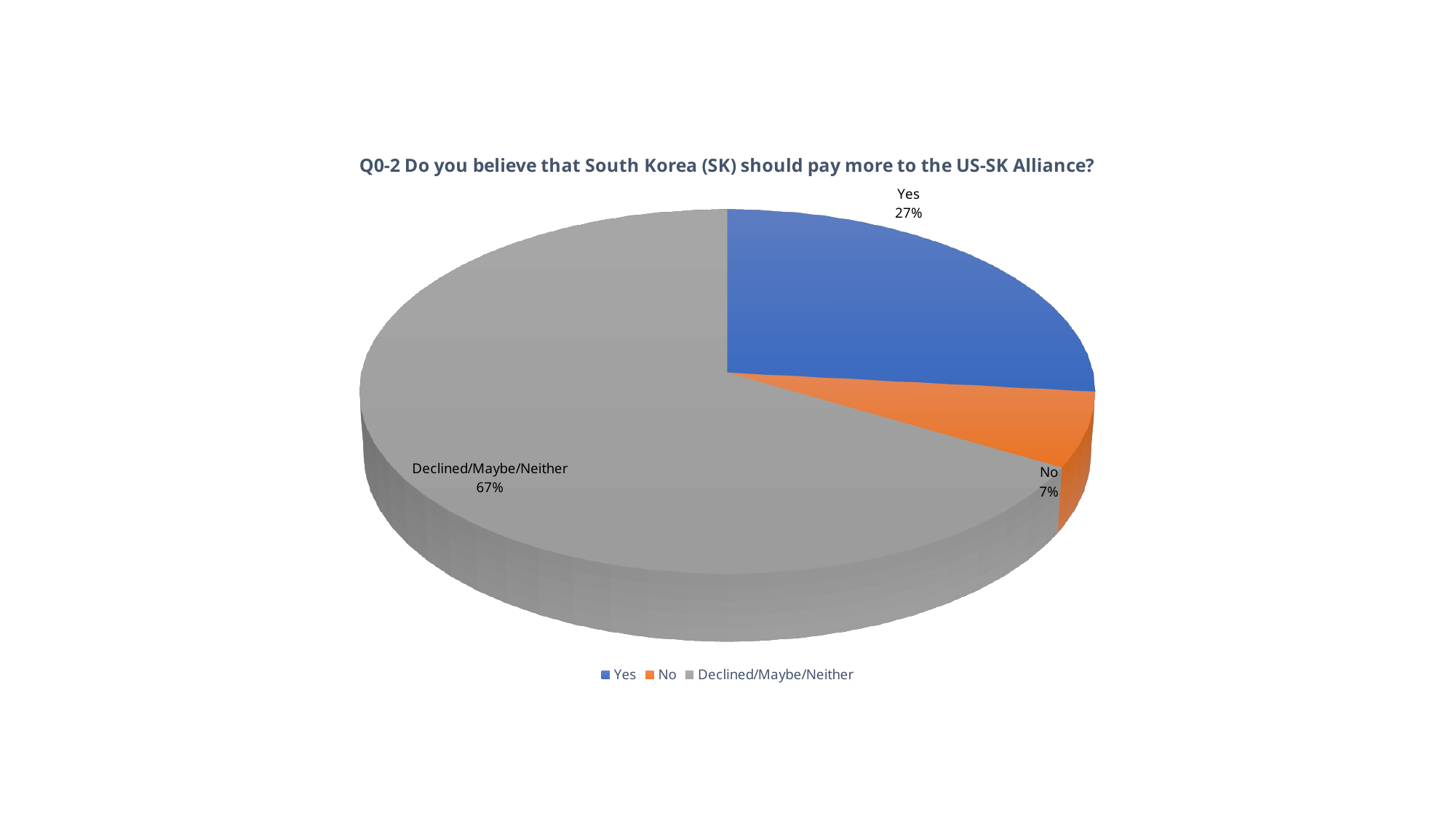
Which category has the smallest slice of the pie? No What share of respondents answered Yes? 27% What colour is the Declined/Maybe/Neither slice? Grey What is the title of the chart? Q0-2 Do you believe that South Korea (SK) should pay more to the US-SK Alliance? Which is larger, the Yes slice or the No slice? Yes How many categories are shown in the pie chart? 3 What is the difference in percentage points between Yes and No? 20 What share of respondents answered No? 7% Which category has the largest slice of the pie? Declined/Maybe/Neither What kind of chart is shown on the slide? Pie chart What share of respondents fall under Declined/Maybe/Neither? 67% What is the difference in percentage points between Declined/Maybe/Neither and Yes? 40